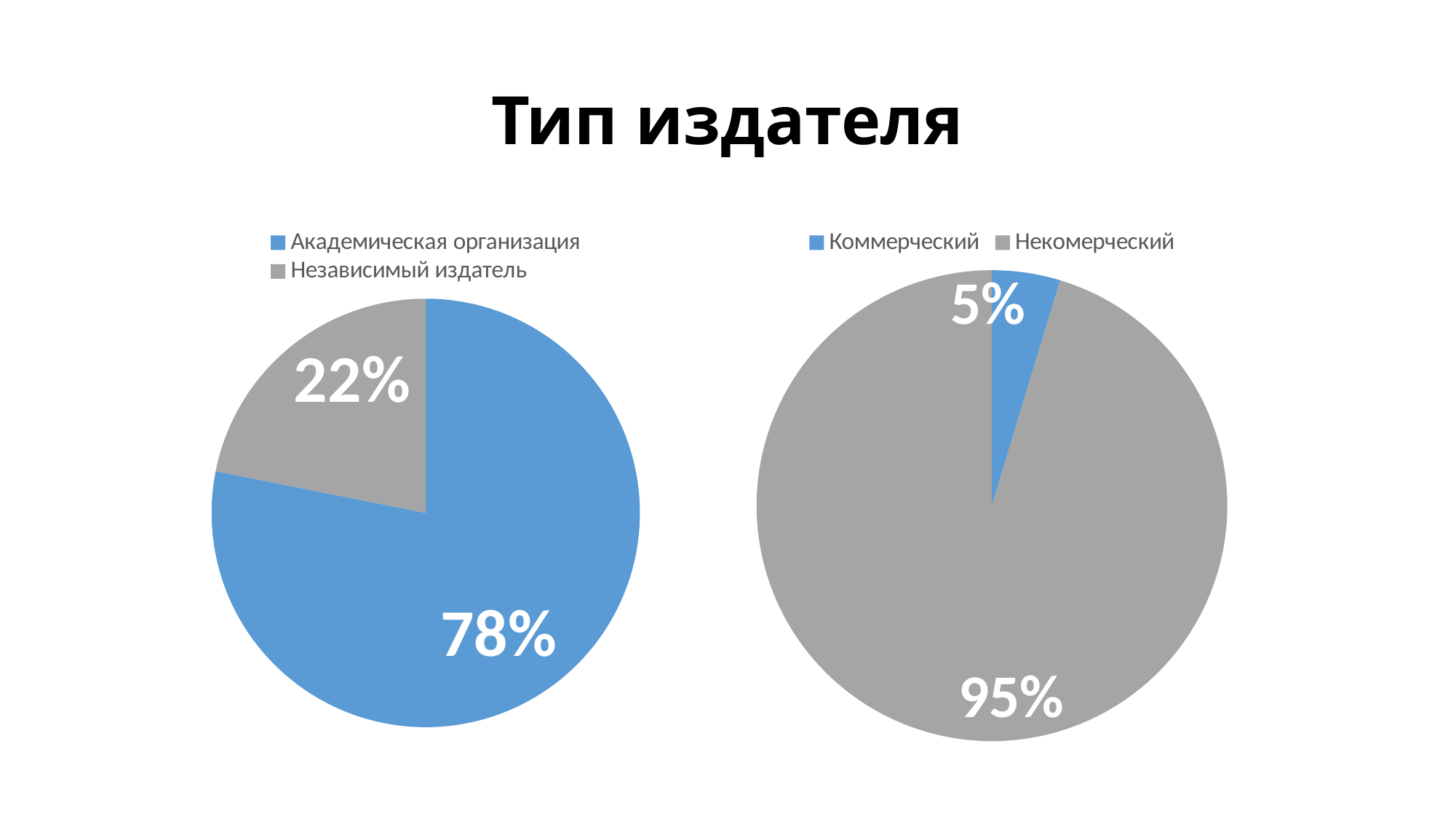
In the right pie chart, which category has the smallest slice? Коммерческий In the right pie chart, which is larger: Коммерческий or Некомерческий? Некомерческий How many slices does the left pie chart have? 2 What type of chart is the right chart on the slide? Pie chart In the left pie chart, what share does Академическая организация have? 78% In the left pie chart, which category has the largest slice? Академическая организация In the right pie chart, what share does Некомерческий have? 95% What is the title of the slide? Тип издателя In the left pie chart, what share does Независимый издатель have? 22% In the left pie chart, what is the difference between the shares of Академическая организация and Независимый издатель? 56% In the right pie chart, what is the difference between the shares of Некомерческий and Коммерческий? 90%